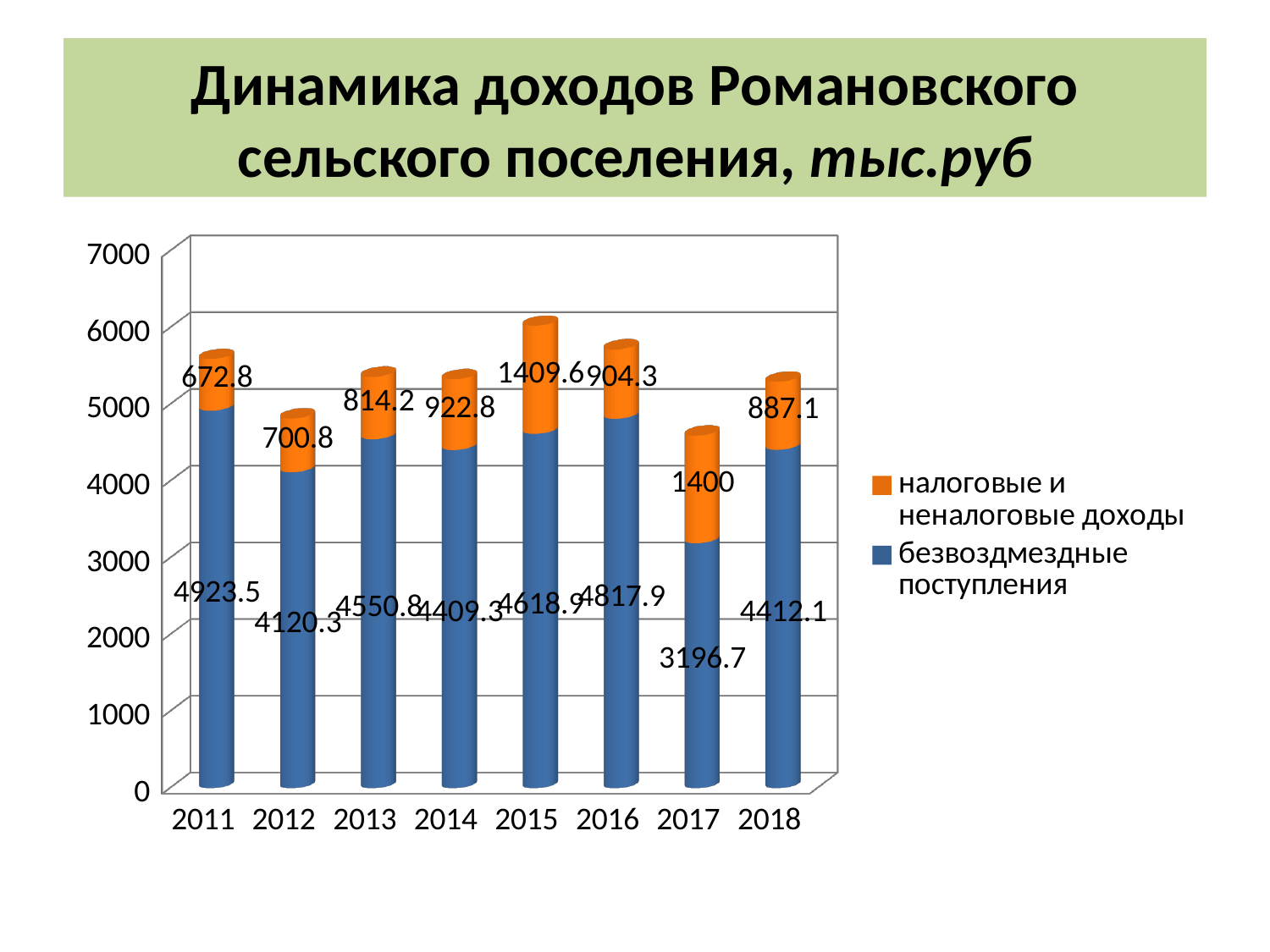
In which year is безвозмездные поступления the highest? 2011 Which is larger: налоговые и неналоговые доходы in 2014 or in 2012? 2014 How many years are shown on the x axis? 8 In which year is безвозмездные поступления the lowest? 2017 What is the difference between безвозмездные поступления in 2016 and 2017? 1621.2 What is the value of безвозмездные поступления for 2017? 3196.7 What is the value of налоговые и неналоговые доходы for 2015? 1409.6 What type of chart is shown on the slide? Stacked bar chart What is the value of безвозмездные поступления for 2011? 4923.5 What is the total of the stacked bar for 2015? 6028.5 Which colour represents налоговые и неналоговые доходы? Orange How many series does the legend list? 2